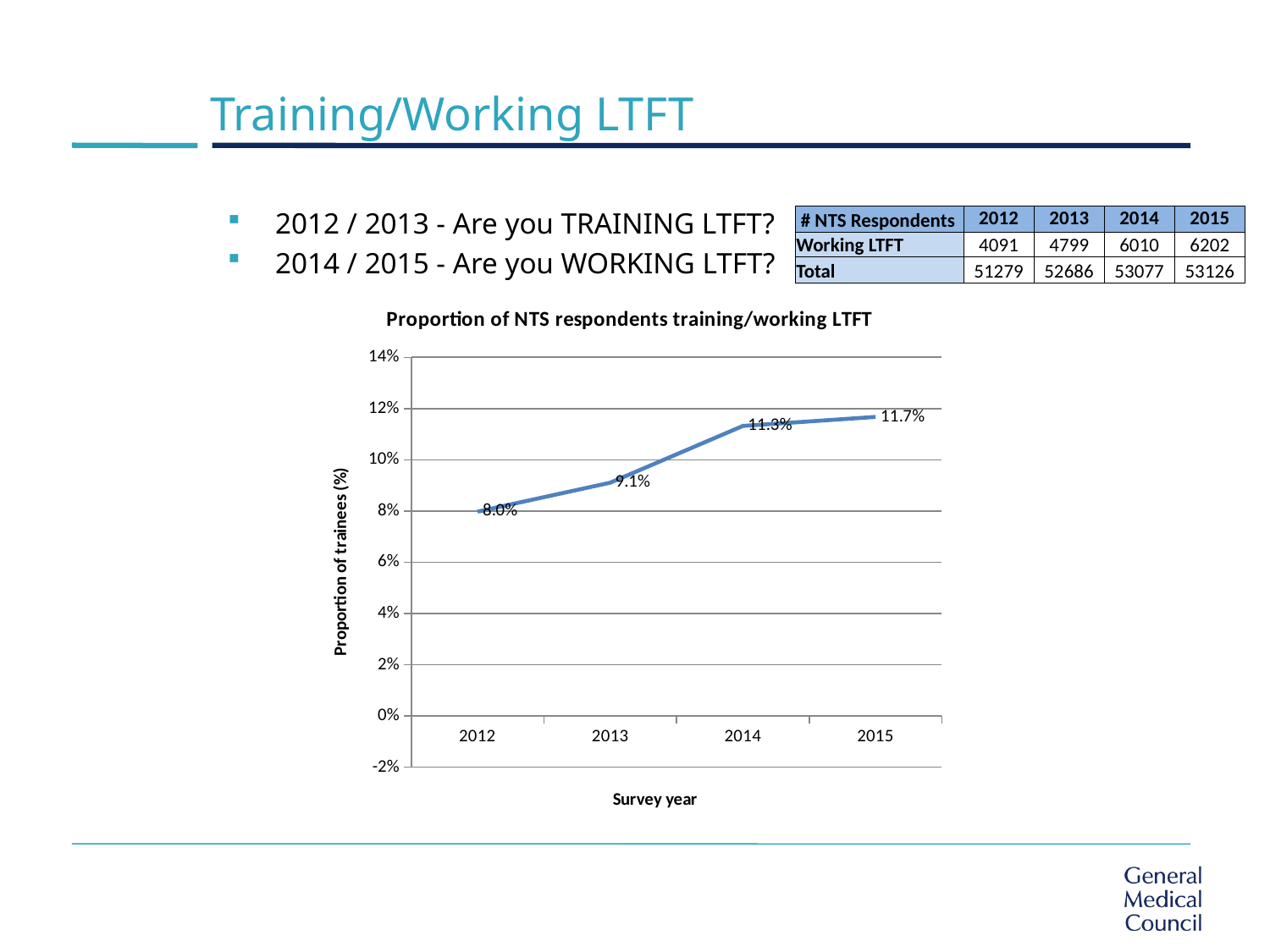
Does the proportion of trainees training/working LTFT rise or fall from 2012 to 2015? rise What is the title of the chart? Proportion of NTS respondents training/working LTFT Which survey year has the lowest proportion of trainees training/working LTFT? 2012 What is the proportion of NTS respondents training/working LTFT in 2015? 11.7% What kind of chart is shown on the slide? line chart What is the difference in percentage points between the 2014 and 2013 values? 2.2 How many survey years are plotted on the chart? 4 Which survey year has the highest proportion of trainees training/working LTFT? 2015 What is the proportion of NTS respondents training/working LTFT in 2012? 8.0% Which is larger, the value for 2013 or the value for 2014? 2014 Is the value for 2013 greater or less than 10%? less What is the proportion of NTS respondents training/working LTFT in 2014? 11.3%